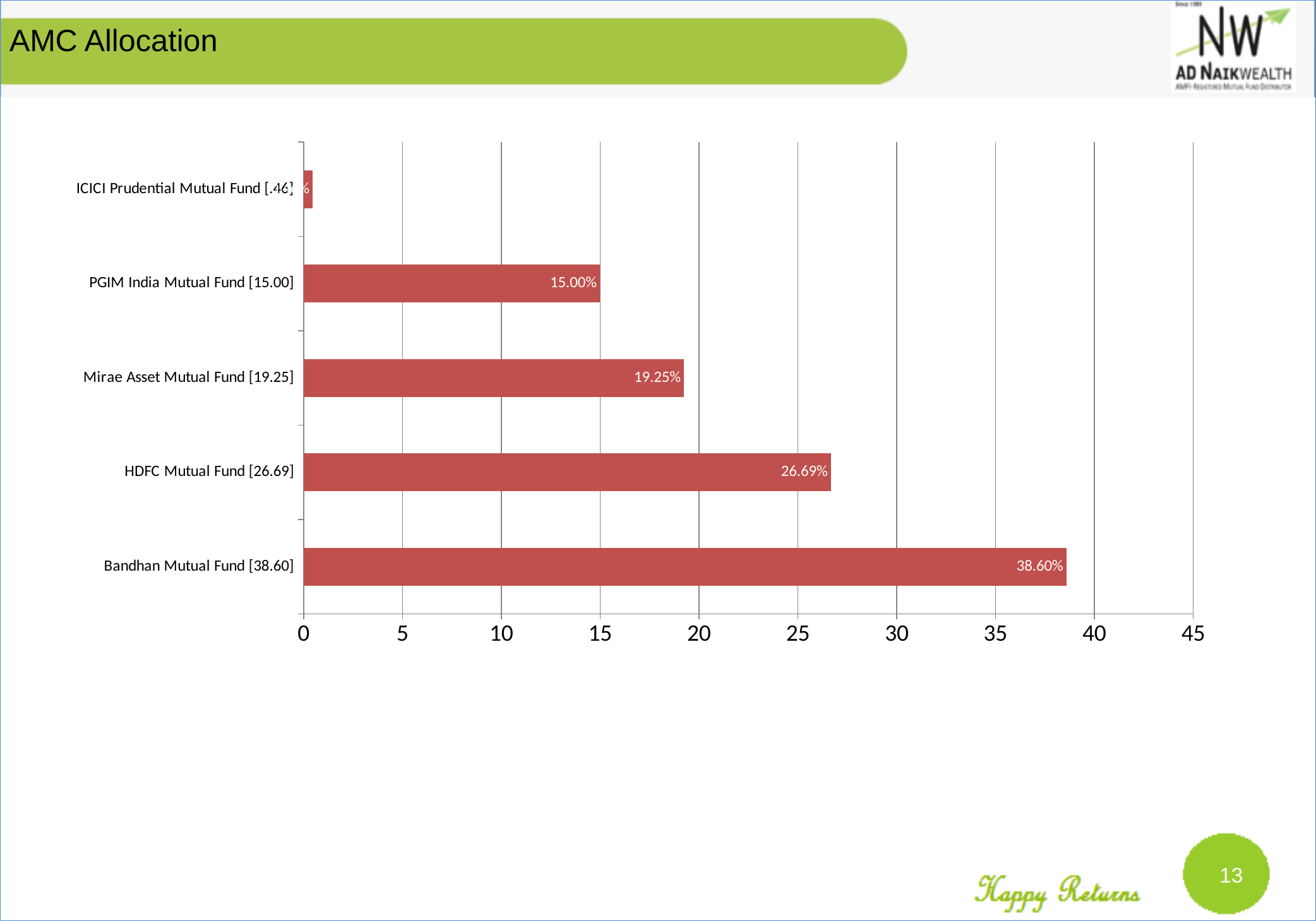
Which fund has the highest allocation? Bandhan Mutual Fund How many funds are shown in the chart? 5 What is the value for Mirae Asset Mutual Fund? 19.25% Which is larger, the value for HDFC Mutual Fund or the value for Mirae Asset Mutual Fund? HDFC Mutual Fund What is the difference between the values for Mirae Asset Mutual Fund and PGIM India Mutual Fund? 4.25% What is the value for HDFC Mutual Fund? 26.69% What kind of chart is shown on the slide? bar chart Is the value for ICICI Prudential Mutual Fund greater or less than 5? less What is the value for Bandhan Mutual Fund? 38.60% Which fund has the lowest allocation? ICICI Prudential Mutual Fund What is the difference between the values for Bandhan Mutual Fund and HDFC Mutual Fund? 11.91% What is the value for PGIM India Mutual Fund? 15.00%